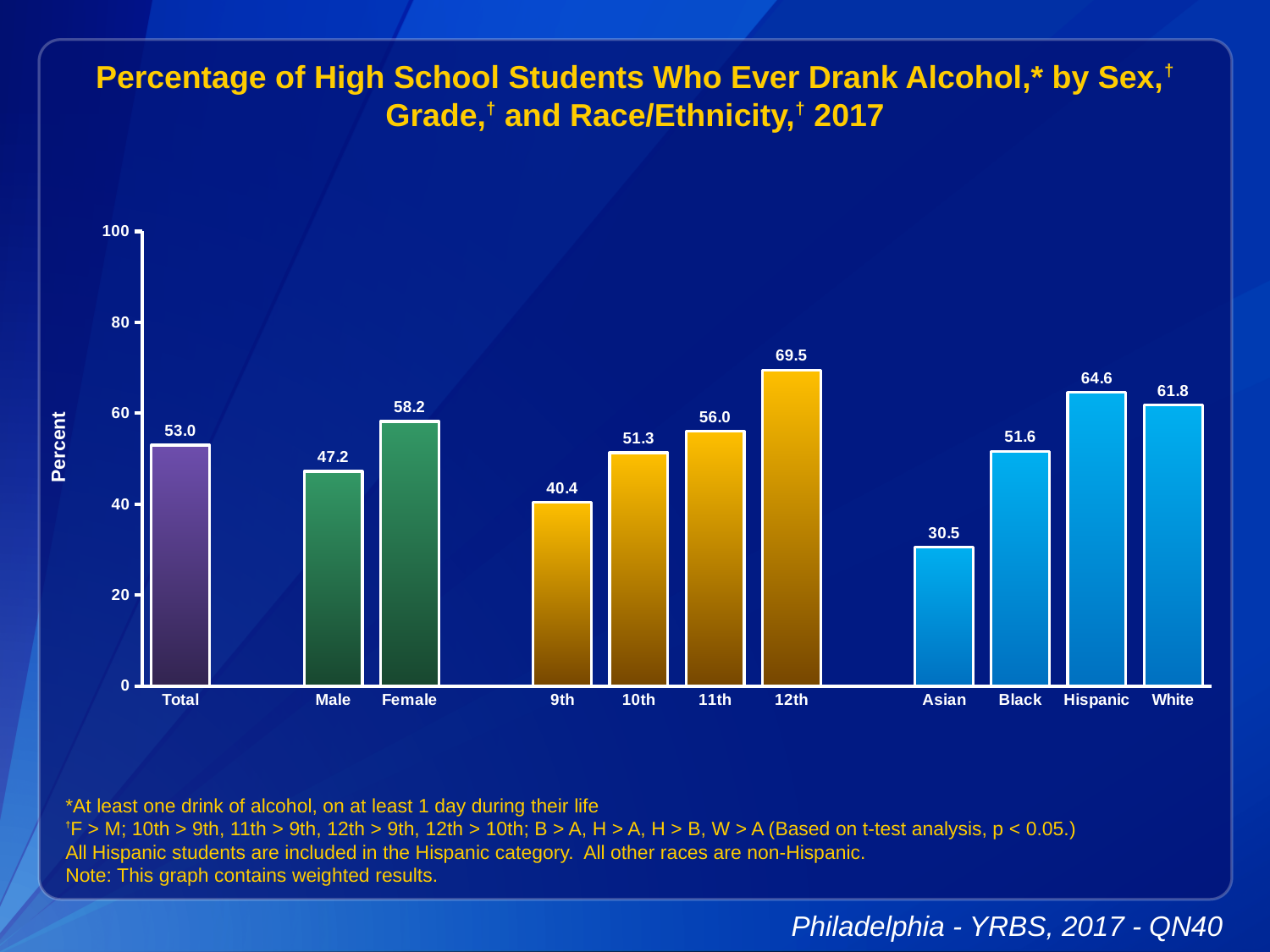
Which is larger, the value for Hispanic or the value for White? Hispanic What percentage of 12th graders ever drank alcohol? 69.5 Which category has the lowest value? Asian What is the value for Asian students? 30.5 What is the value for Total? 53.0 What is the difference between the Female and Male values? 11.0 Which category has the highest value? 12th What is the label on the y axis? Percent Is the value for 9th graders greater or less than 40? greater Do the values rise or fall from 9th grade to 12th grade? rise How many bars are shown in the chart? 11 What kind of chart is shown? bar chart